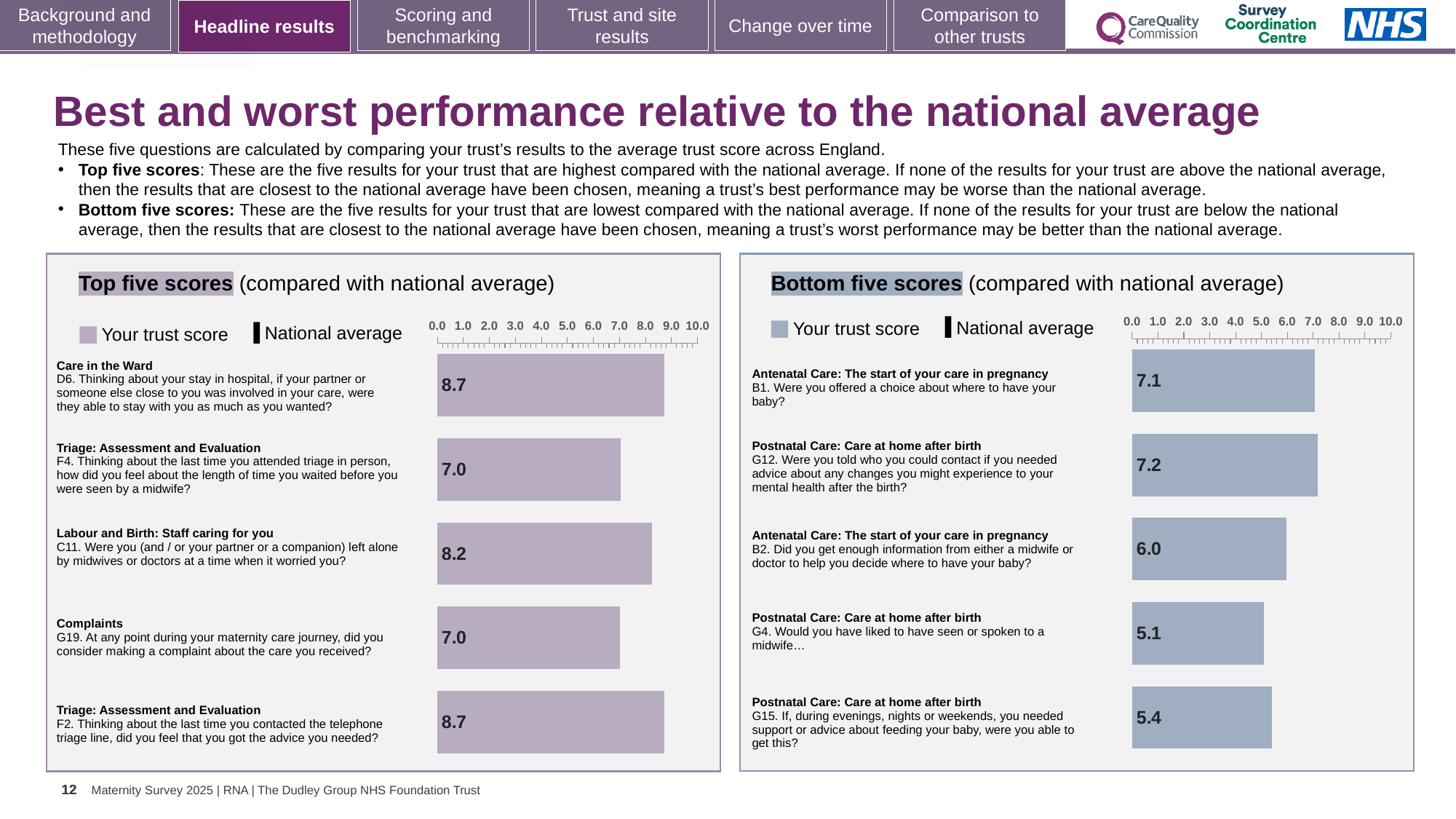
In the Bottom five scores chart, what is the trust score for G4 (Postnatal Care: Care at home after birth)? 5.1 What type of chart is the Bottom five scores chart? bar chart How many questions are shown in the Top five scores chart? 5 In the Top five scores chart, what is the trust score for C11 (Labour and Birth: Staff caring for you)? 8.2 In the Bottom five scores chart, what is the difference between the trust scores for G12 and G4? 2.1 In the Top five scores chart, what is the trust score for D6 (Care in the Ward)? 8.7 In the Bottom five scores chart, what is the trust score for B1 (Antenatal Care: The start of your care in pregnancy)? 7.1 In the Top five scores chart, what is the difference between the trust scores for D6 and F4? 1.7 In the Top five scores chart, which has the larger trust score, C11 or G19? C11 In the Bottom five scores chart, is the trust score for B2 greater or less than 7.0? less In the Bottom five scores chart, which question has the highest trust score? G12 In the Bottom five scores chart, which question has the lowest trust score? G4